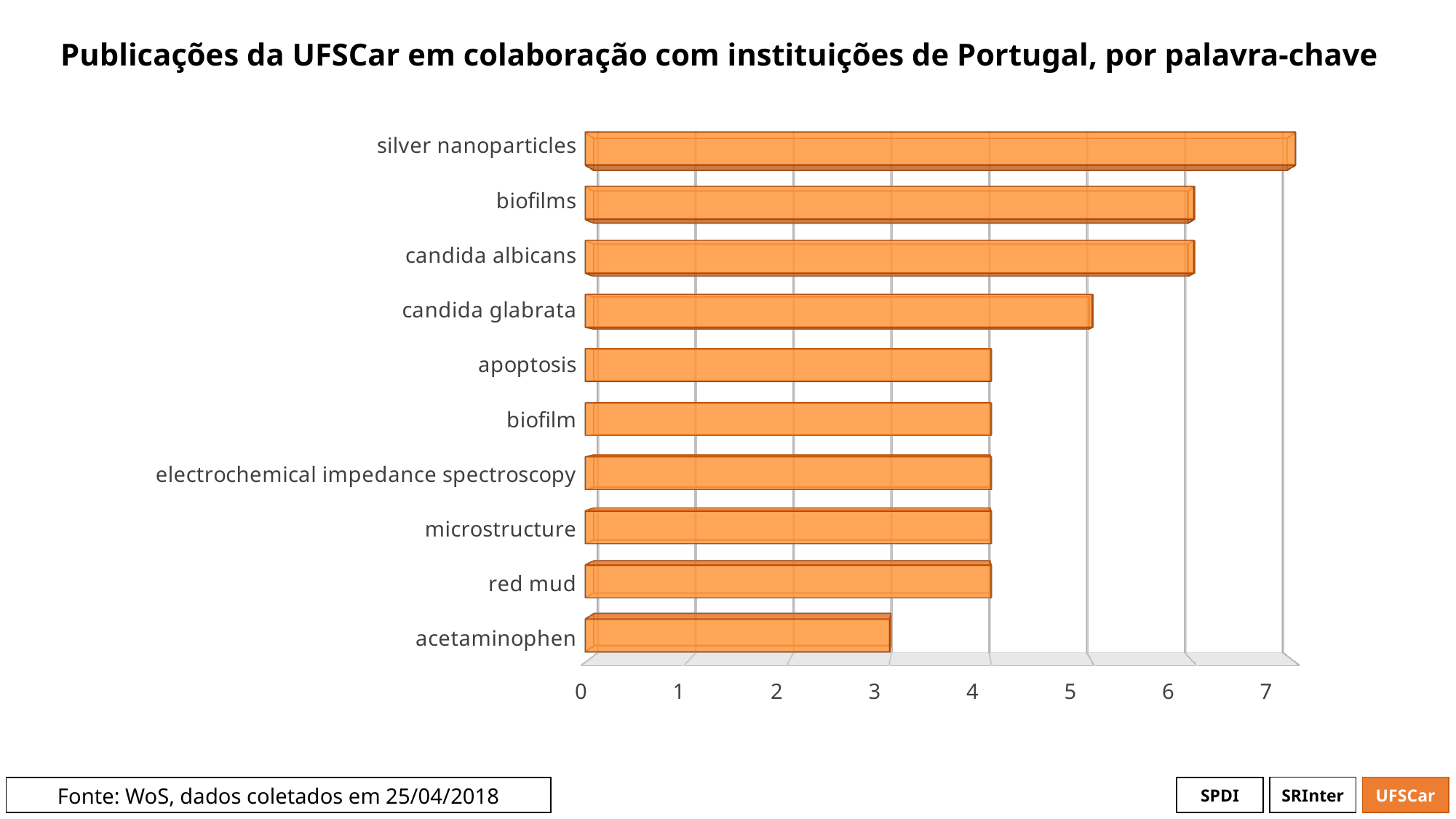
What is the source of the data cited on the slide? WoS, dados coletados em 25/04/2018 Which keyword has the highest number of publications? silver nanoparticles What is the title of the chart? Publicações da UFSCar em colaboração com instituições de Portugal, por palavra-chave Is the value for acetaminophen greater or less than 4? less Which has more publications, red mud or acetaminophen? red mud How many keywords (categories) are shown in the chart? 10 Which has more publications, biofilms or candida glabrata? biofilms What kind of chart is shown on the slide? bar chart Which keyword has the lowest number of publications? acetaminophen Is the value for apoptosis greater or less than 5? less Is the value for silver nanoparticles greater or less than 6? greater